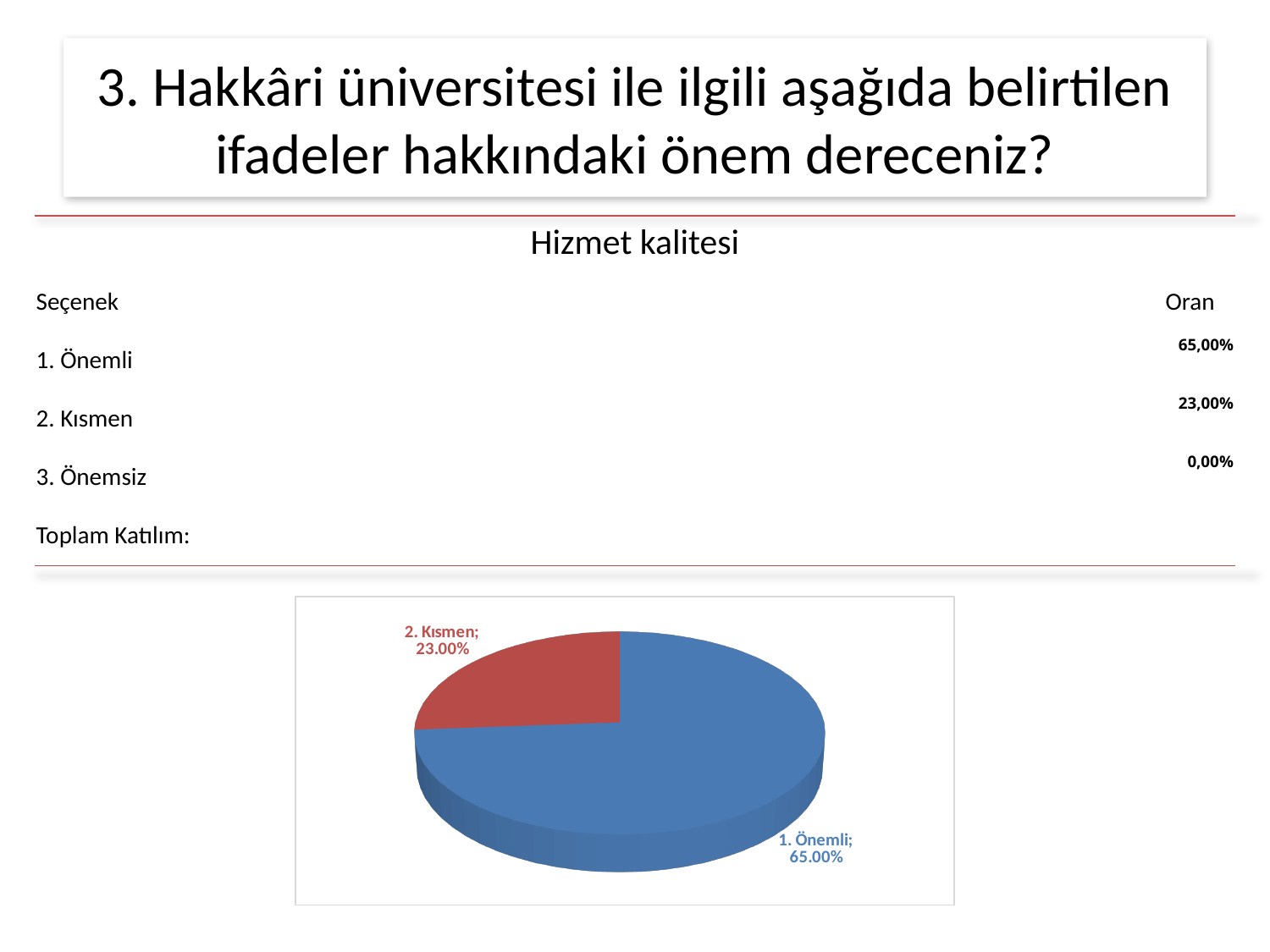
What colour is the "1. Önemli" slice in the pie chart? blue What colour is the "2. Kısmen" slice in the pie chart? red What is the difference between the "1. Önemli" and "2. Kısmen" shares in the pie chart? 42.00% What kind of chart is shown on the slide? pie chart Which slice of the pie chart is the largest? 1. Önemli What percentage does the pie chart show for "2. Kısmen"? 23.00% What percentage does the pie chart show for "1. Önemli"? 65.00% How many labeled slices does the pie chart show? 2 Which labeled slice of the pie chart is the smallest? 2. Kısmen What share of the pie does the "2. Kısmen" slice represent? 23.00% Which is larger in the pie chart, "1. Önemli" or "2. Kısmen"? 1. Önemli